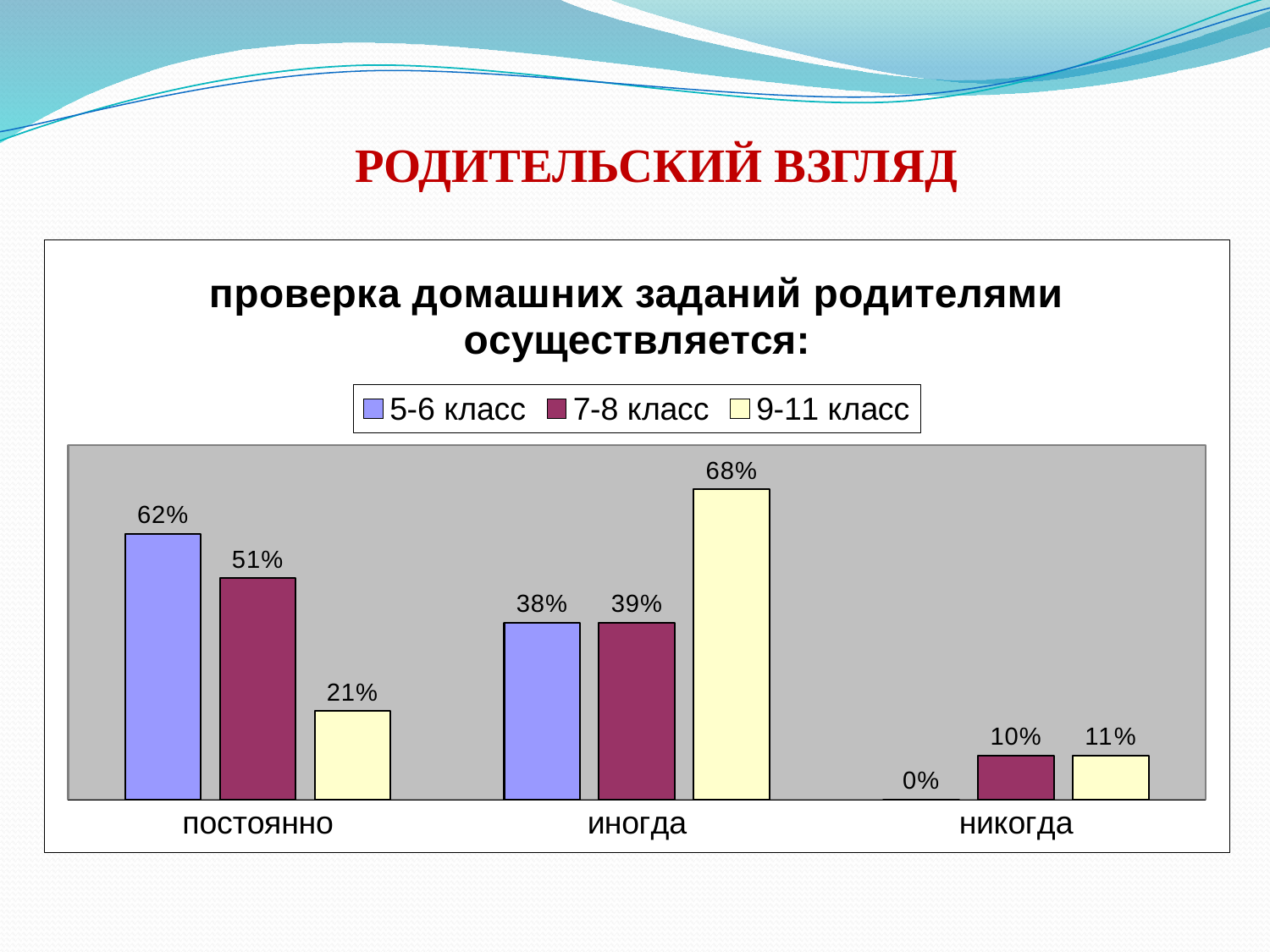
What is the value for 9-11 класс in the иногда category? 68% What kind of chart is shown? bar chart Which series has the lowest value in the никогда category? 5-6 класс What is the value for 5-6 класс in the постоянно category? 62% Which series has the highest value in the иногда category? 9-11 класс How many series does the legend list? 3 What is the value for 9-11 класс in the постоянно category? 21% What is the difference between the 5-6 класс and 9-11 класс values in the постоянно category? 41% What is the title of the chart? проверка домашних заданий родителями осуществляется: Which is larger in the постоянно category: 5-6 класс or 7-8 класс? 5-6 класс How many categories are shown on the x axis? 3 What is the value for 7-8 класс in the никогда category? 10%